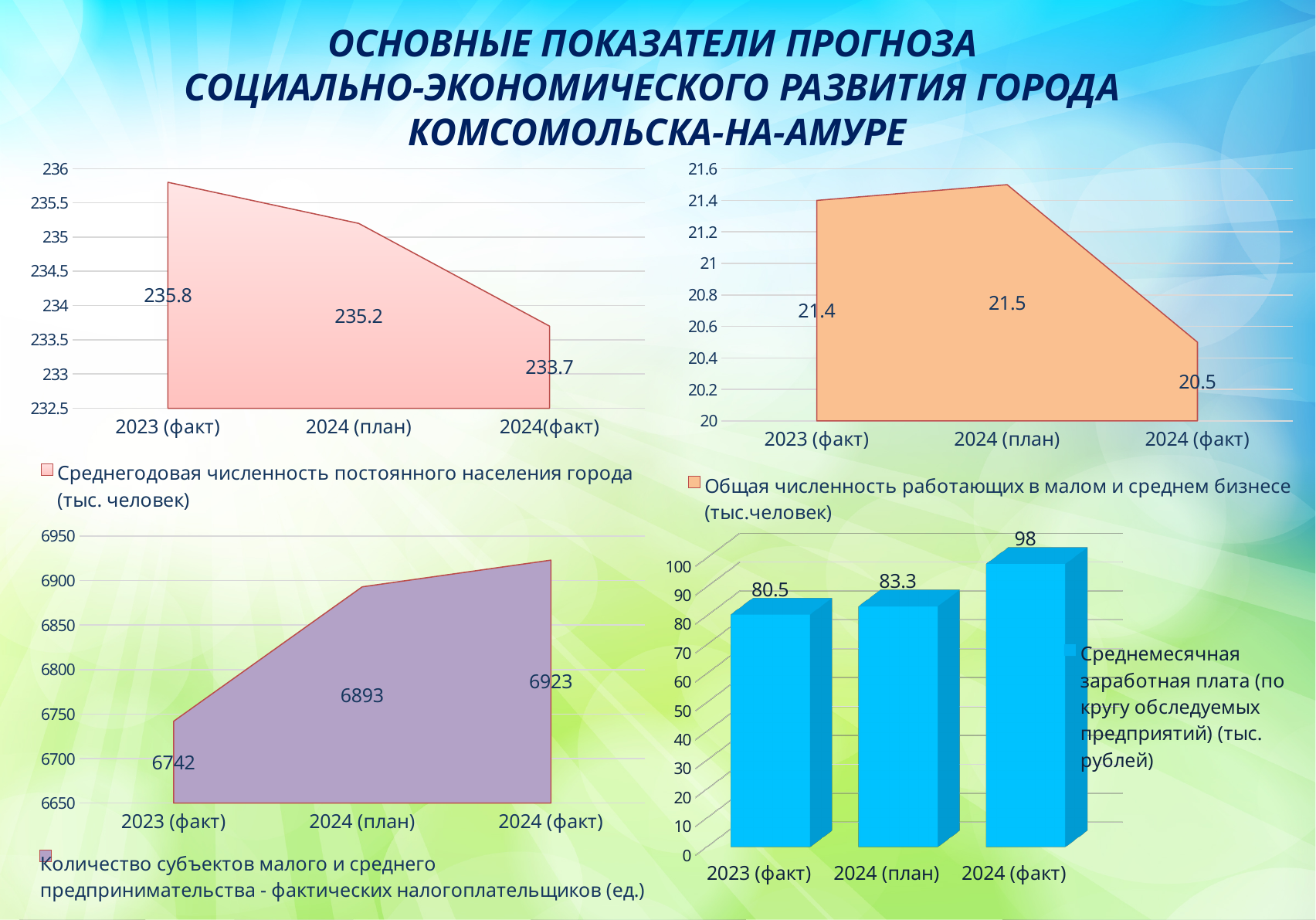
In the bottom-left chart (number of small and medium business entities), what is the value for 2024 (план)? 6893 In the top-left chart (average annual population), what is the difference between the 2023 (факт) value and the 2024(факт) value? 2.1 In the bottom-left chart (number of small and medium business entities), do the values rise or fall from 2023 (факт) to 2024 (факт)? rise In the top-right chart (number of people working in small and medium business), what is the value for 2024 (план)? 21.5 In the top-left chart (average annual population), which category has the lowest value? 2024(факт) In the top-left chart (average annual population), what is the value for 2023 (факт)? 235.8 In the bottom-right chart (average monthly salary), what is the value for 2024 (факт)? 98 In the top-right chart (number of people working in small and medium business), which is larger: the value for 2023 (факт) or the value for 2024 (факт)? 2023 (факт) In the bottom-right chart (average monthly salary), what is the difference between the 2024 (факт) value and the 2023 (факт) value? 17.5 In the bottom-left chart (number of small and medium business entities), which category has the highest value? 2024 (факт) How many categories are shown on the x axis of the top-right chart (number of people working in small and medium business)? 3 What kind of chart is the bottom-right chart (average monthly salary)? bar chart